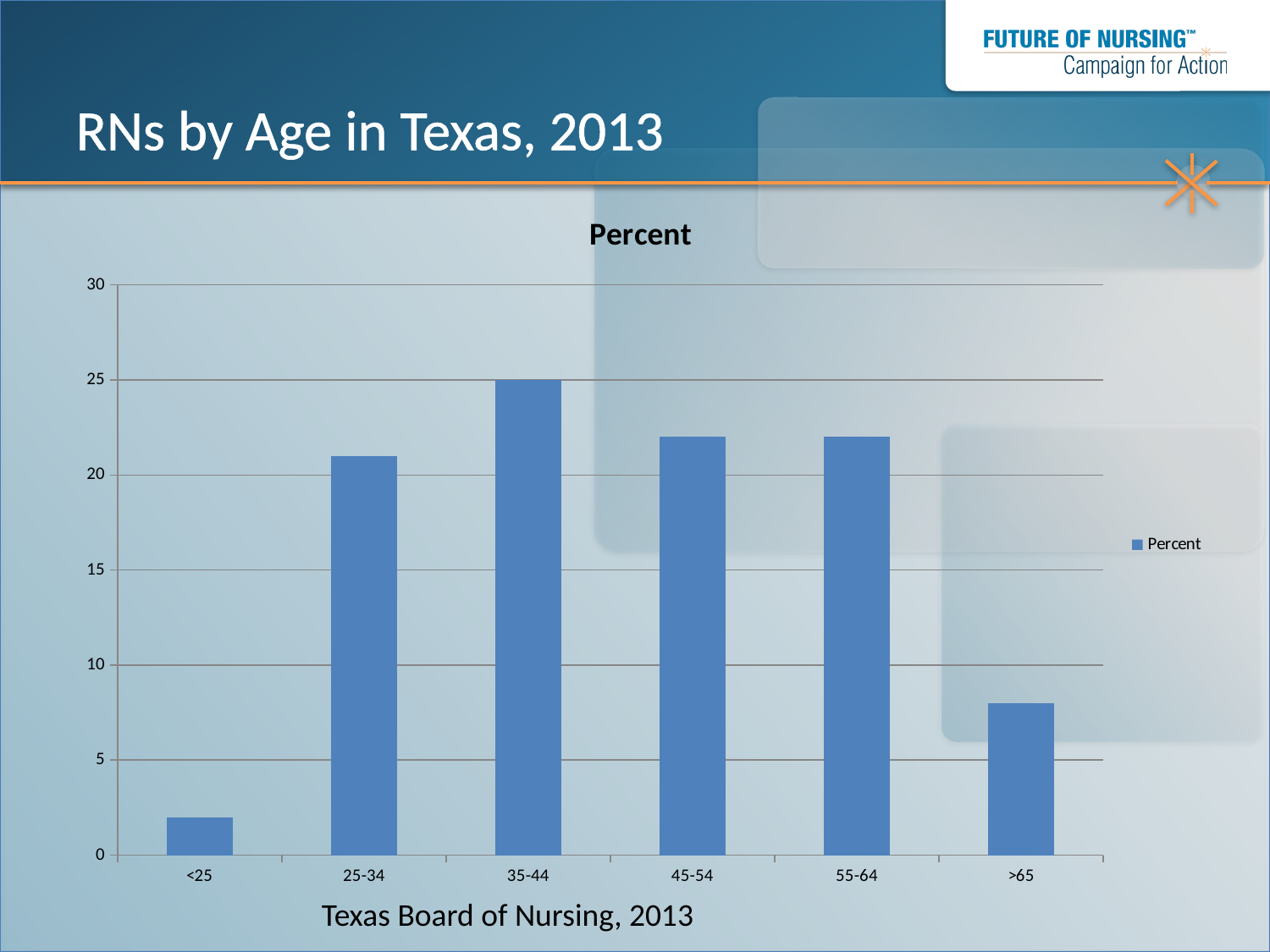
Is the value for the 25-34 age group greater or less than 20? greater Which age group has the lowest value? <25 Which is larger, the value for <25 or the value for >65? >65 How many age categories are shown on the x axis? 6 Which age group has the highest value? 35-44 Is the value for the >65 age group greater or less than 10? less Is the value for the <25 age group greater or less than 5? less What is the value for the 35-44 age group? 25 How many series does the legend list? 1 What is the chart's title? Percent What type of chart is shown on the slide? bar chart Which is larger, the value for 25-34 or the value for 35-44? 35-44